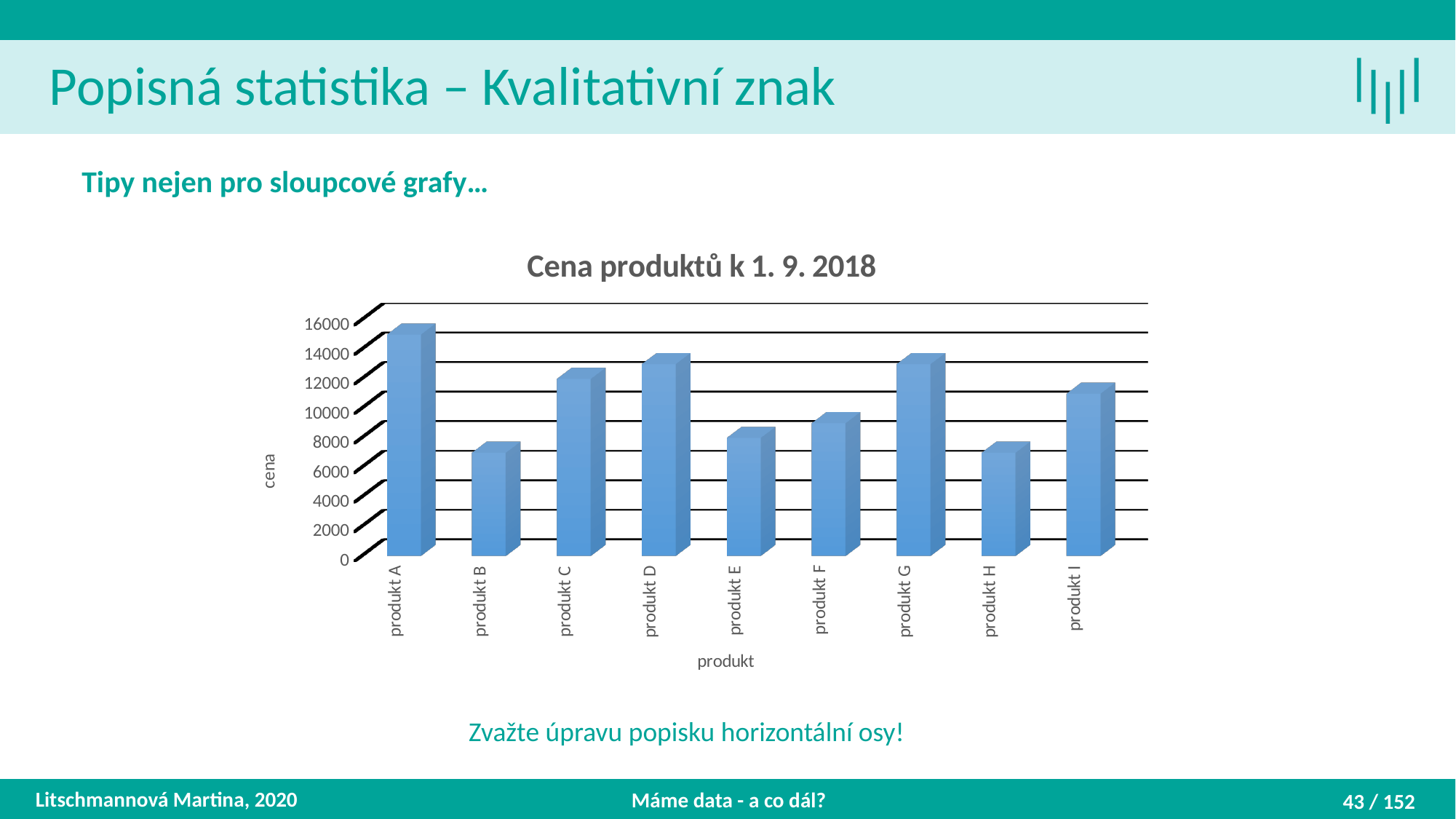
What is the label of the vertical axis of the chart? cena How many products are shown on the x axis of the chart? 9 Is the value for produkt I greater or less than 10000? greater Which has a higher value, produkt C or produkt E? produkt C Which has a higher value, produkt H or produkt I? produkt I What is the title of the chart? Cena produktů k 1. 9. 2018 Is the value for produkt B greater or less than 8000? less Is the value for produkt E greater or less than 10000? less What kind of chart is shown on the slide? bar chart Which product has the highest price in the chart? produkt A